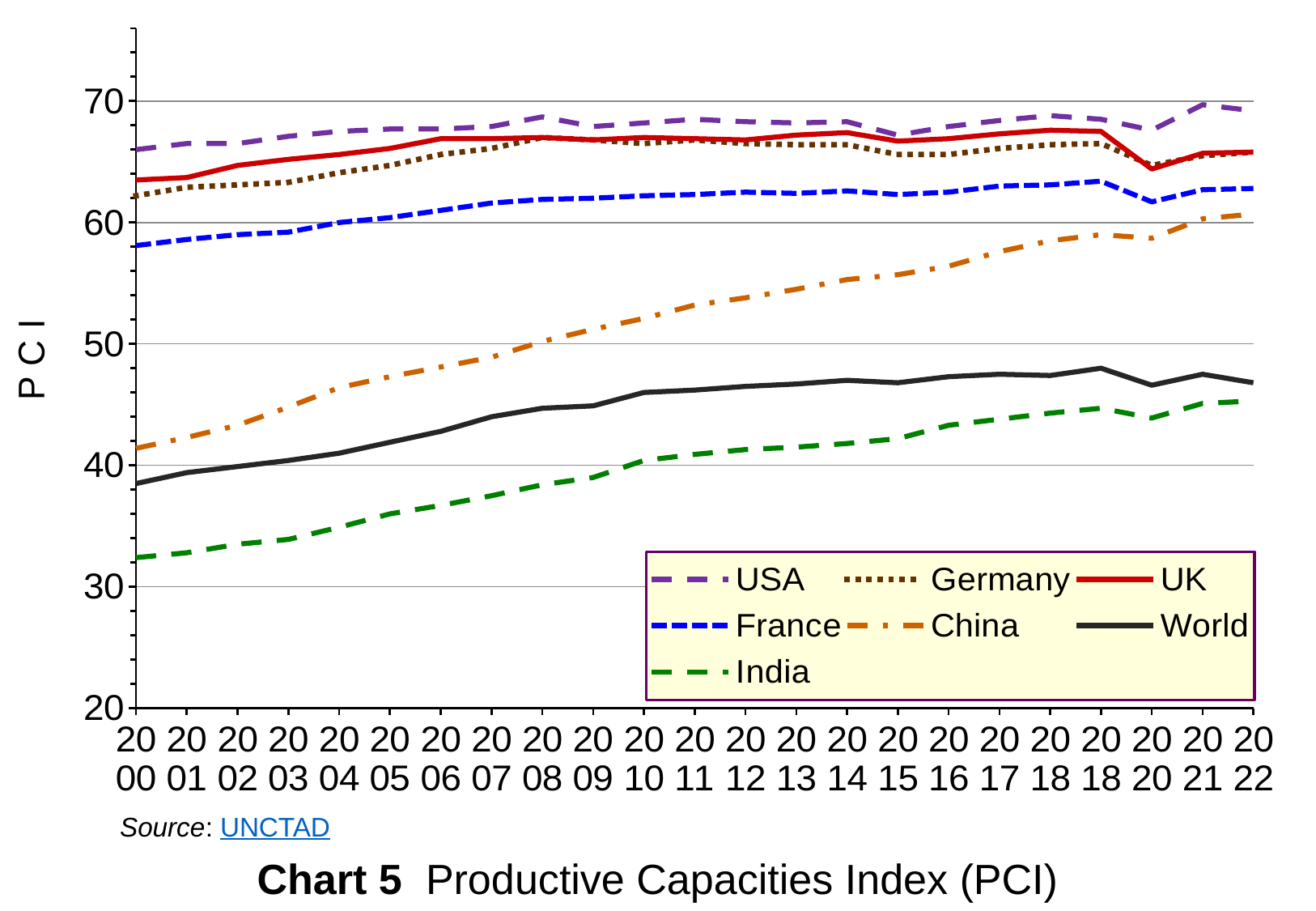
In 2022, which has the higher PCI value, USA or UK? USA Which series has the highest PCI value in 2000? USA Is the PCI value for France in 2000 greater or less than 60? less Does the PCI value for China rise or fall from 2000 to 2022? rise Is the PCI value for India in 2000 greater or less than 40? less How many years are labelled on the x axis of Chart 5? 23 How many series does the legend of Chart 5 list? 7 Is the PCI value for China in 2000 greater or less than 50? less What source is cited below Chart 5? UNCTAD What kind of chart is Chart 5? line chart Which series has the lowest PCI value in 2022? India